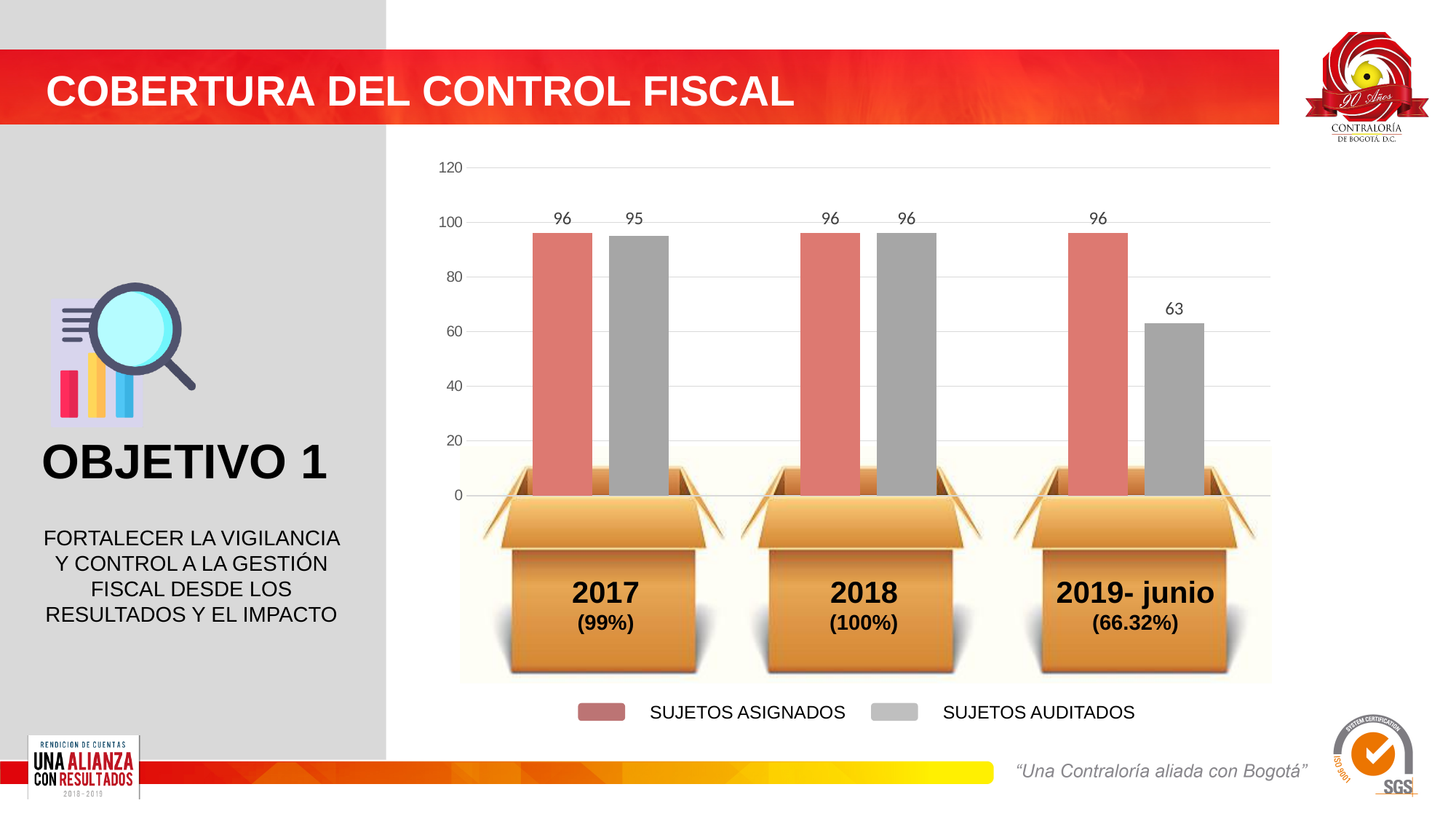
Is the value of SUJETOS AUDITADOS for 2019- junio greater or less than 80? less What kind of chart is shown on the slide? bar chart What is the value of SUJETOS ASIGNADOS for 2017? 96 What is the value of SUJETOS AUDITADOS for 2017? 95 Which period has the lowest value for SUJETOS AUDITADOS? 2019- junio What percentage is shown under the 2019- junio label? 66.32% What is the value of SUJETOS AUDITADOS for 2018? 96 What is the difference between SUJETOS ASIGNADOS and SUJETOS AUDITADOS for 2019- junio? 33 What is the value of SUJETOS AUDITADOS for 2019- junio? 63 Which is larger for 2019- junio, SUJETOS ASIGNADOS or SUJETOS AUDITADOS? SUJETOS ASIGNADOS How many periods are shown on the x axis of the chart? 3 How many series does the legend list? 2